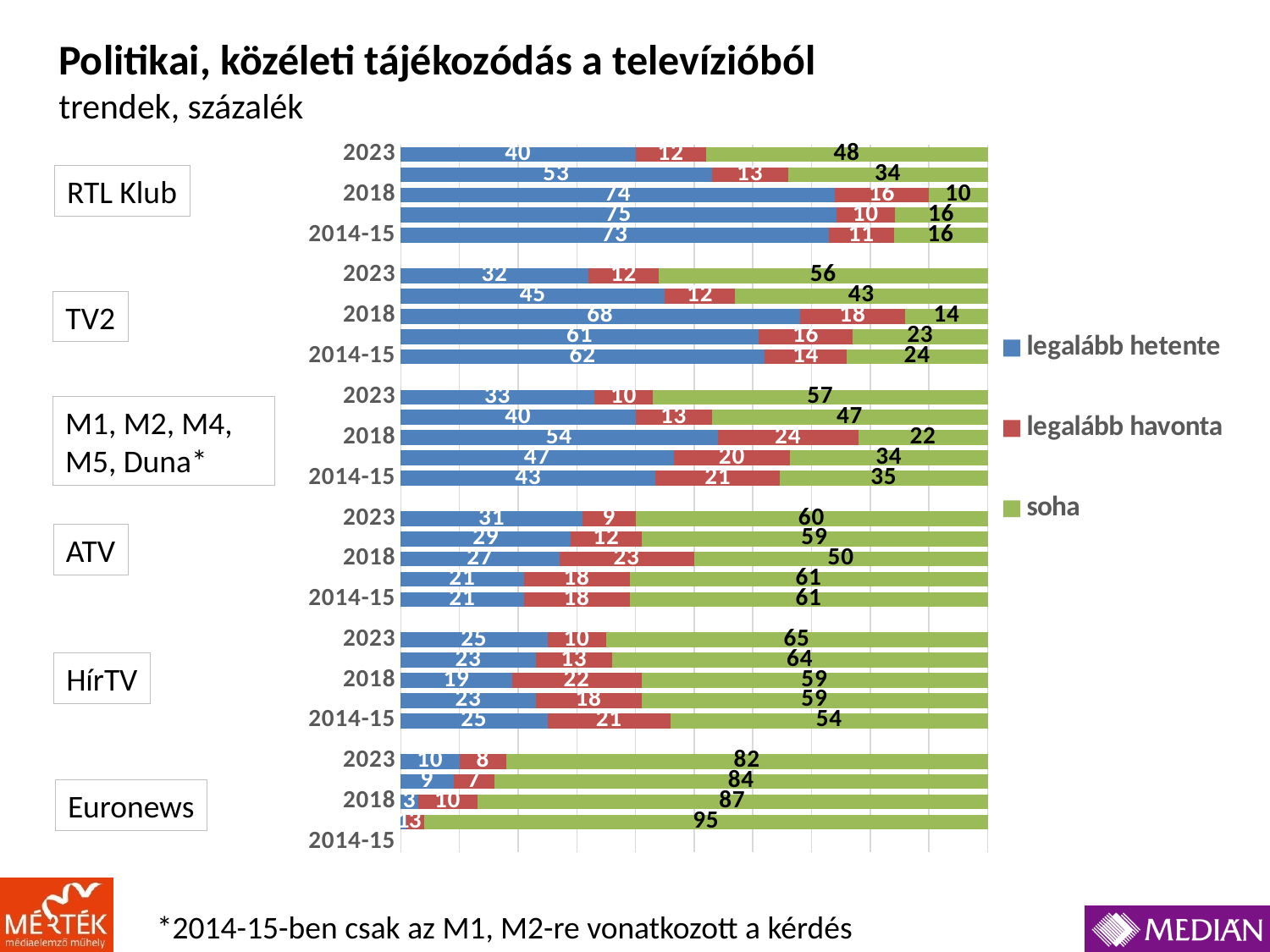
What is the 'soha' value for TV2 in 2023? 56 What is the 'legalább hetente' value for RTL Klub in 2023? 40 Which channel has the lowest 'legalább hetente' value in 2023? Euronews What is the difference between the 'legalább hetente' values for RTL Klub in 2018 and 2023? 34 What is the 'legalább havonta' value for M1, M2, M4, M5, Duna in 2018? 24 Which channel has the highest 'legalább hetente' value in 2023? RTL Klub What is the total of the stacked bar for TV2 in 2018? 100 Which is larger: the 'soha' value for ATV in 2023 or for HírTV in 2023? HírTV in 2023 Which legend entry is shown in green? soha How many series does the legend list? 3 What type of chart is shown on the slide? stacked bar chart